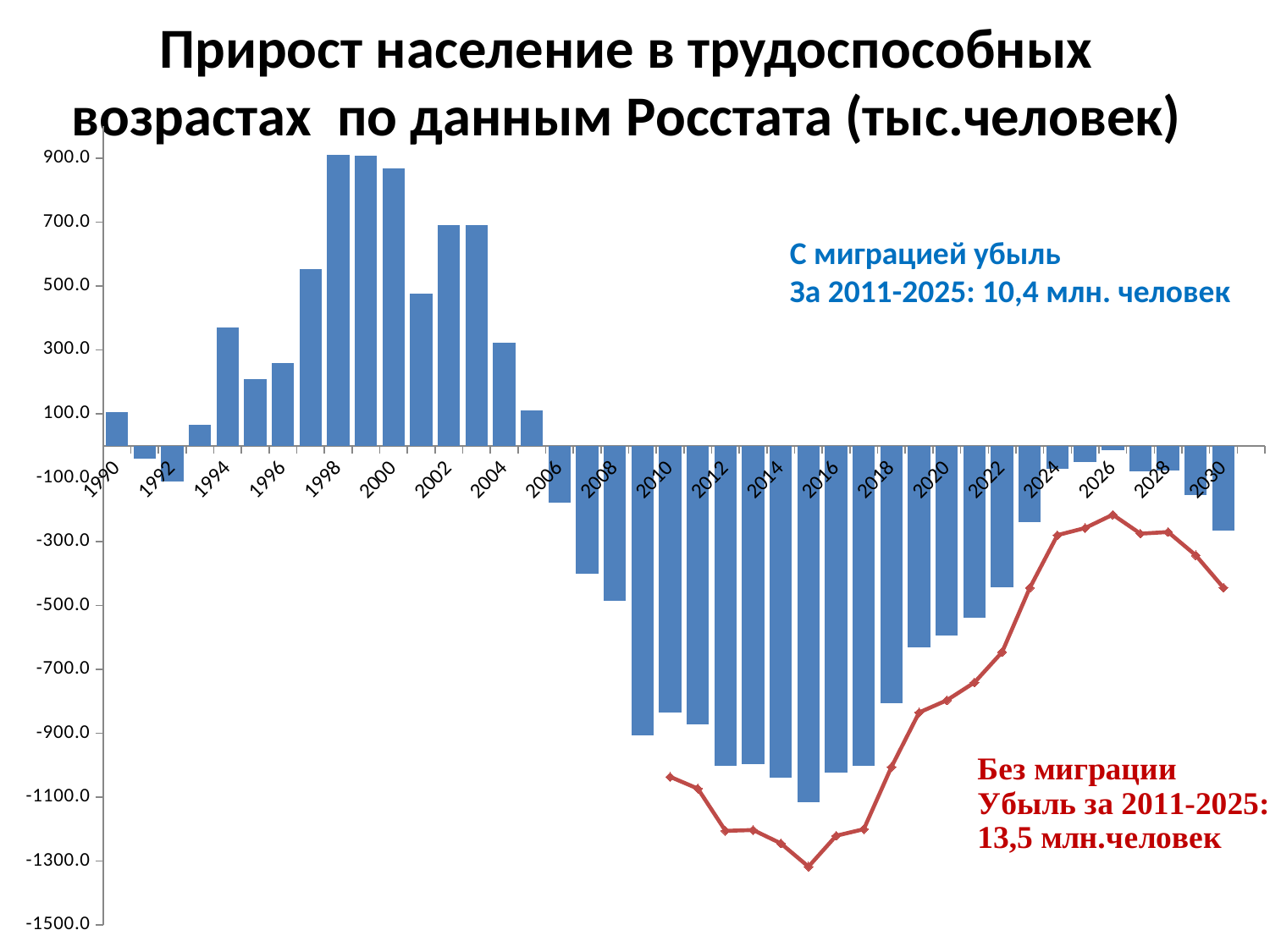
Is the bar value for 1994 greater or less than 300? greater What kind of chart is shown on the slide? combination bar and line chart Which year has the lowest (most negative) bar? 2015 According to the red annotation, what is the population decline for 2011-2025 without migration? 13,5 млн.человек Which year has the larger bar value, 1998 or 1994? 1998 Is the bar value for 2015 greater or less than -1000? less Do the bar values rise or fall from 1999 to 2006? fall Is the bar value for 1998 greater or less than 700? greater According to the blue annotation, what is the population decline for 2011-2025 with migration? 10,4 млн. человек Which year has the larger bar value, 2010 or 2015? 2010